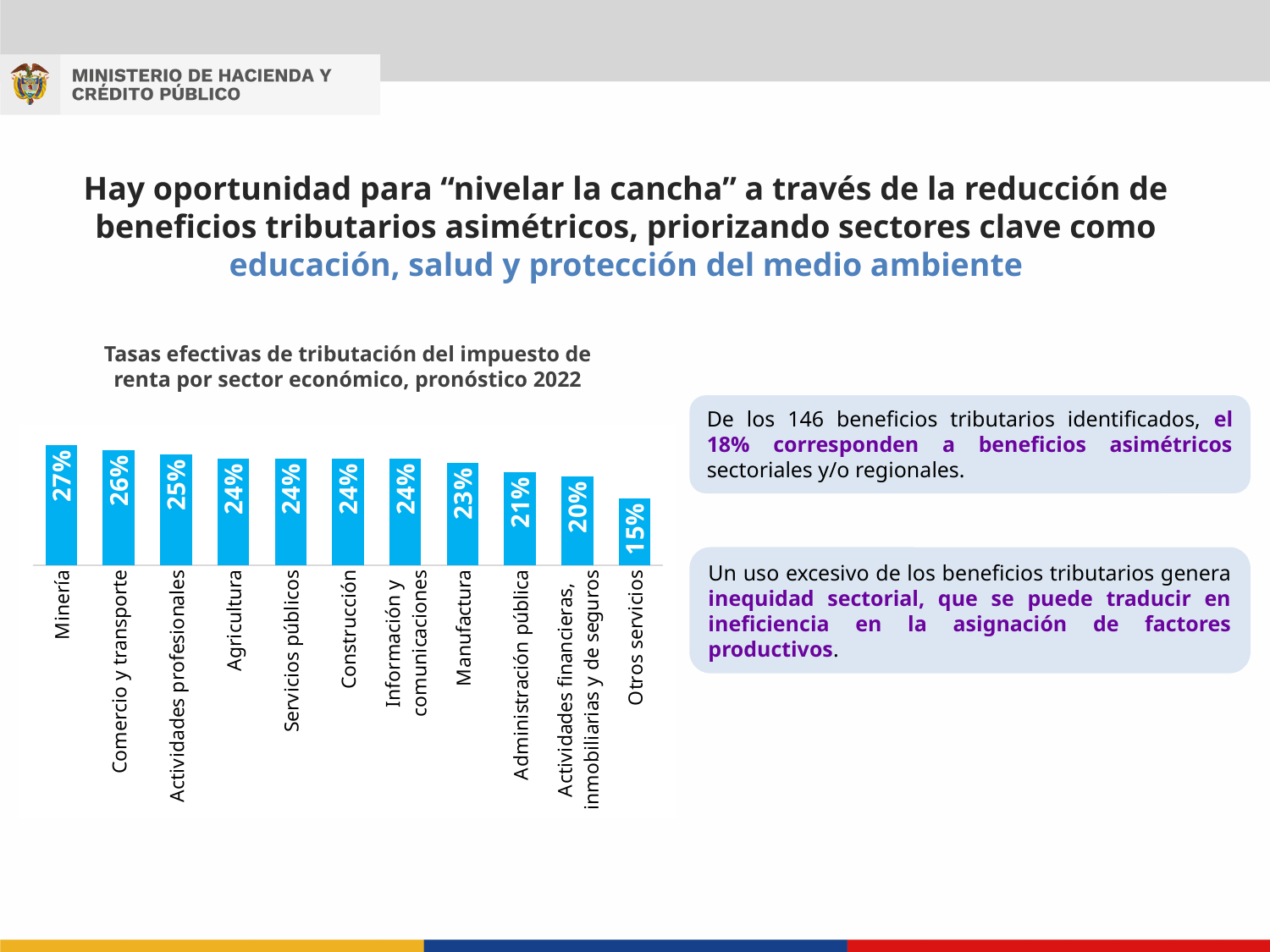
What is the difference between the values for Minería and Otros servicios? 12% Which is larger, the value for Actividades profesionales or the value for Actividades financieras, inmobiliarias y de seguros? Actividades profesionales What type of chart is used on the slide? Bar chart What is the difference between the values for Comercio y transporte and Manufactura? 3% What is the title of the chart? Tasas efectivas de tributación del impuesto de renta por sector económico, pronóstico 2022 What is the effective tax rate shown for Minería? 27% What is the value shown for Manufactura? 23% What is the value shown for Administración pública? 21% What is the value shown for Otros servicios? 15% Which sector has the highest effective tax rate in the chart? Minería How many sectors are shown in the chart? 11 Which sector has the lowest effective tax rate in the chart? Otros servicios